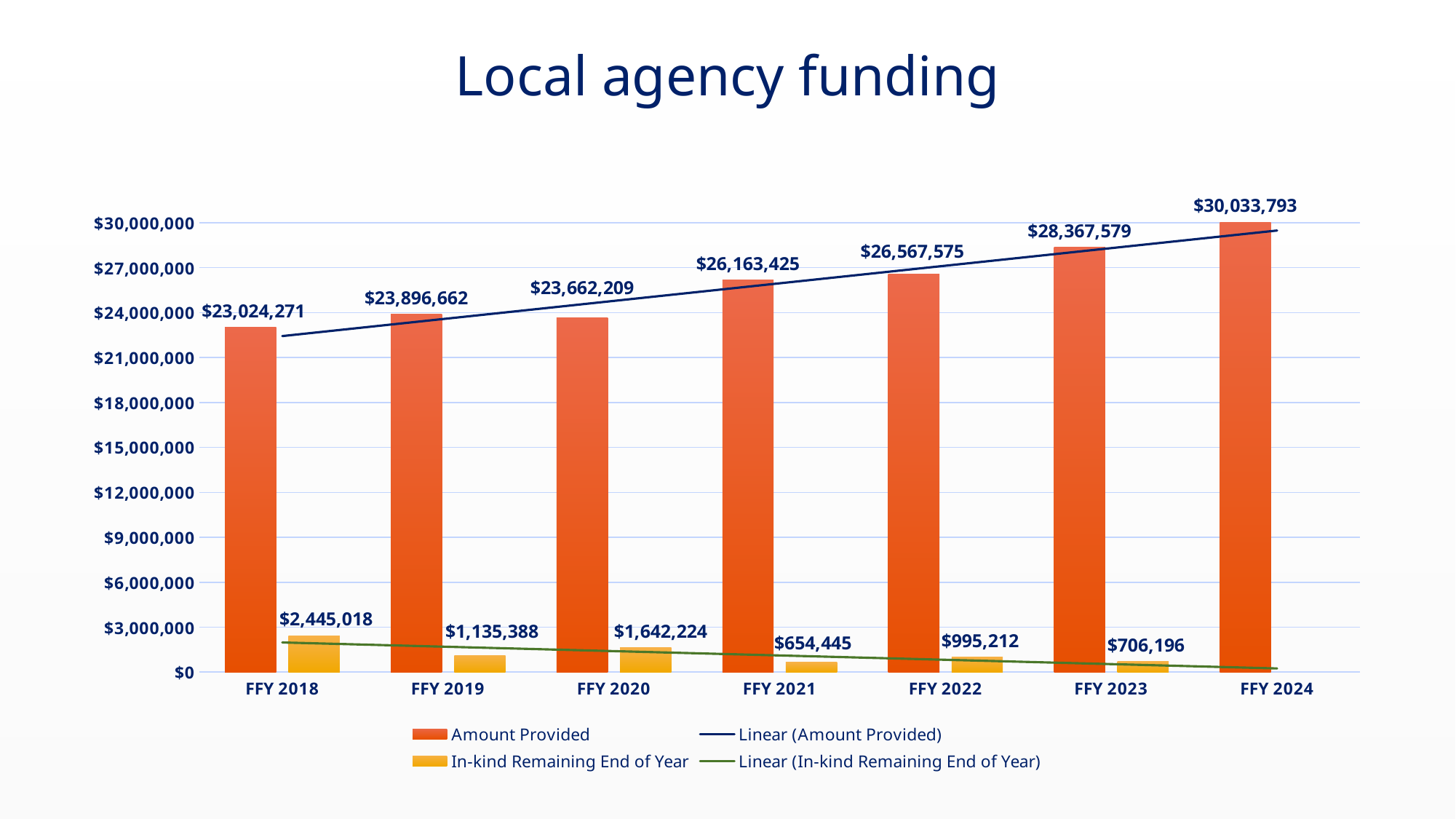
What is the Amount Provided for FFY 2021? $26,163,425 How many entries does the legend list? 4 Is the Amount Provided for FFY 2023 greater or less than $27,000,000? greater Which fiscal year has the lowest In-kind Remaining End of Year value? FFY 2021 How many fiscal years are shown on the x axis? 7 What is the In-kind Remaining End of Year value for FFY 2020? $1,642,224 Does the Amount Provided generally rise or fall from FFY 2018 to FFY 2024? Rise Which is larger, the Amount Provided in FFY 2019 or in FFY 2020? FFY 2019 What kind of chart is shown on the slide? Bar chart What is the difference between the Amount Provided in FFY 2024 and in FFY 2018? $7,009,522 Which fiscal year has the highest Amount Provided? FFY 2024 What is the difference between the In-kind Remaining End of Year values for FFY 2018 and FFY 2021? $1,790,573